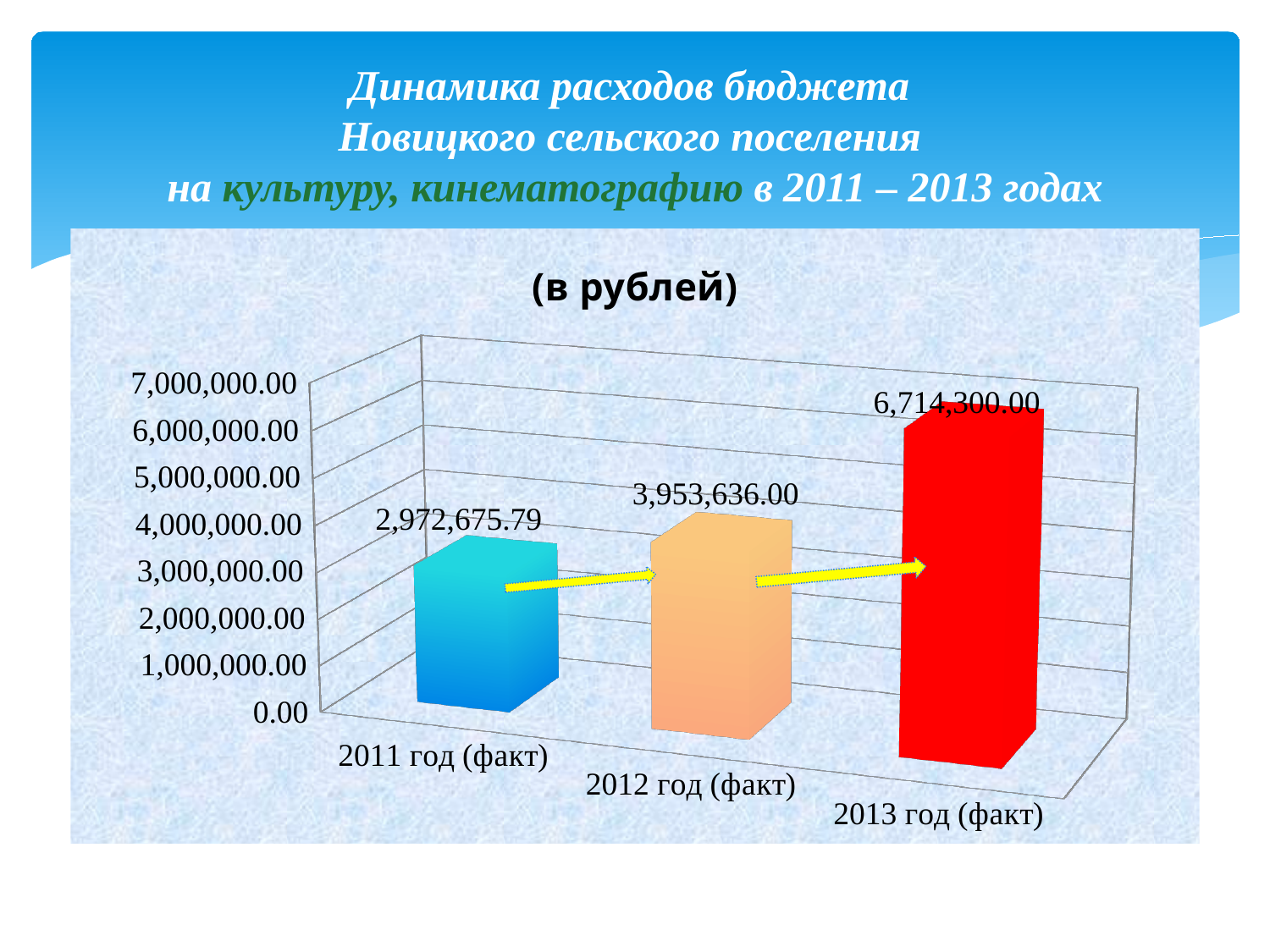
What is the difference between the values for 2013 год (факт) and 2012 год (факт)? 2,760,664.00 Is the value for 2013 год (факт) greater or less than 6,000,000.00? greater What is the difference between the values for 2012 год (факт) and 2011 год (факт)? 980,960.21 What kind of chart is shown on the slide? bar chart What is the value for 2012 год (факт)? 3,953,636.00 Which category has the lowest value? 2011 год (факт) Do the values rise or fall from 2011 год (факт) to 2013 год (факт)? rise How many categories are shown in the chart? 3 Which category has the highest value? 2013 год (факт) Which is larger, the value for 2012 год (факт) or the value for 2011 год (факт)? 2012 год (факт) What is the value for 2011 год (факт)? 2,972,675.79 What is the value for 2013 год (факт)? 6,714,300.00